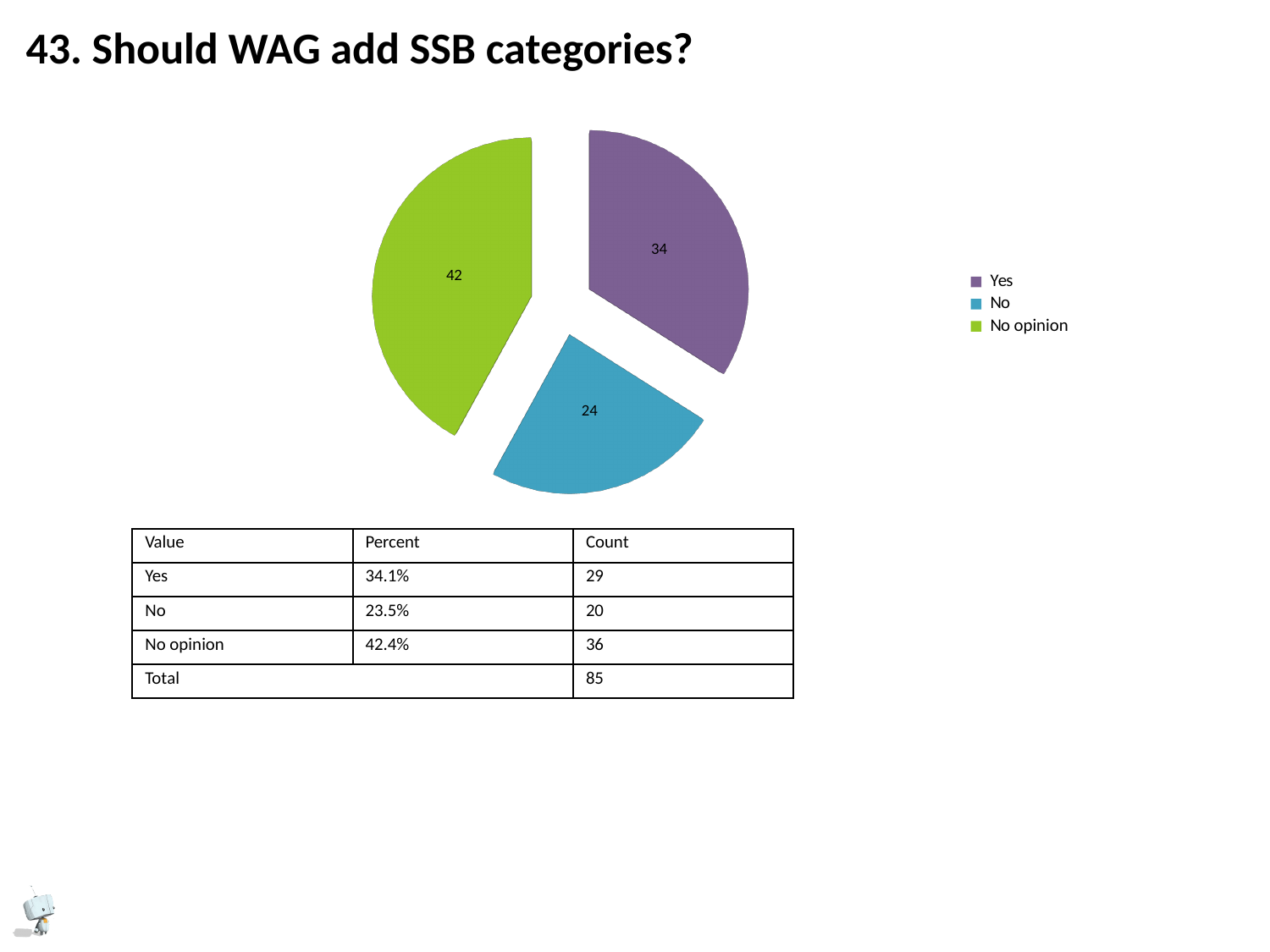
What value is labelled on the No slice of the pie chart? 24 How many slices does the pie chart have? 3 What is the difference between the labelled values for Yes and No in the pie chart? 10 Which category has the largest slice in the pie chart? No opinion What is the difference between the labelled values for No opinion and Yes in the pie chart? 8 What type of chart is shown on the slide? pie chart How many entries does the legend of the pie chart list? 3 What value is labelled on the Yes slice of the pie chart? 34 Which slice is larger in the pie chart, Yes or No? Yes What colour is the No opinion slice in the pie chart? green What value is labelled on the No opinion slice of the pie chart? 42 Which category has the smallest slice in the pie chart? No